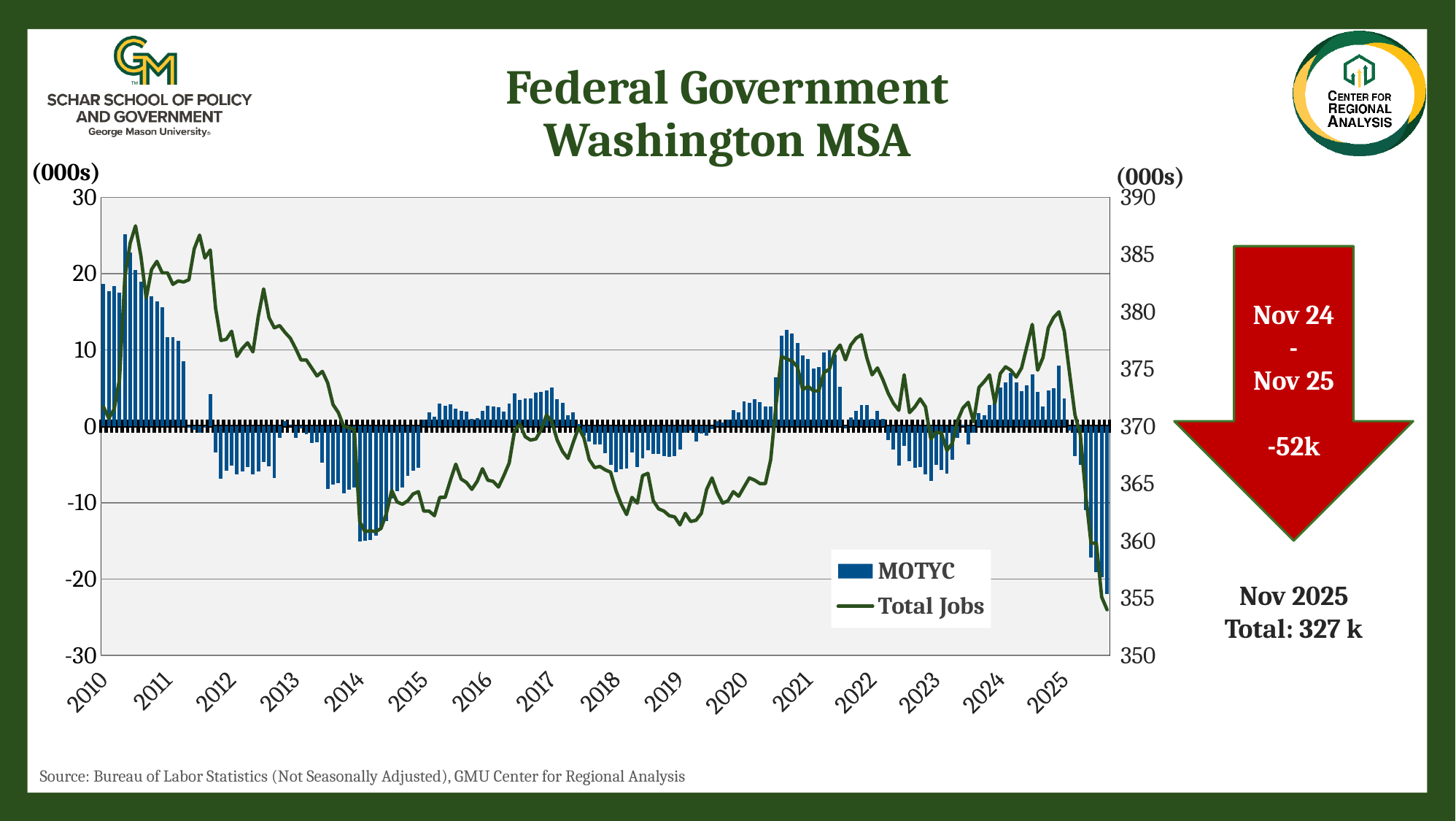
How many series does the chart legend list? 2 What total is printed on the slide for Nov 2025? 327 k In which year does the Total Jobs line reach its lowest point? 2025 What is the title of the chart? Federal Government Washington MSA In which year does the Total Jobs line reach its highest point? 2010 Is the Total Jobs value at its 2011 peak greater or less than 380? greater What are the two series named in the chart legend? MOTYC and Total Jobs Is the Total Jobs value in mid-2014 greater or less than 365? less Is the MOTYC value at the end of 2025 greater or less than -10? less What kind of chart is shown on the slide? A combined bar and line chart Does the Total Jobs line rise or fall from its 2024 peak to the end of 2025? Fall What change in federal government jobs from Nov 24 to Nov 25 is printed in the red arrow? -52k